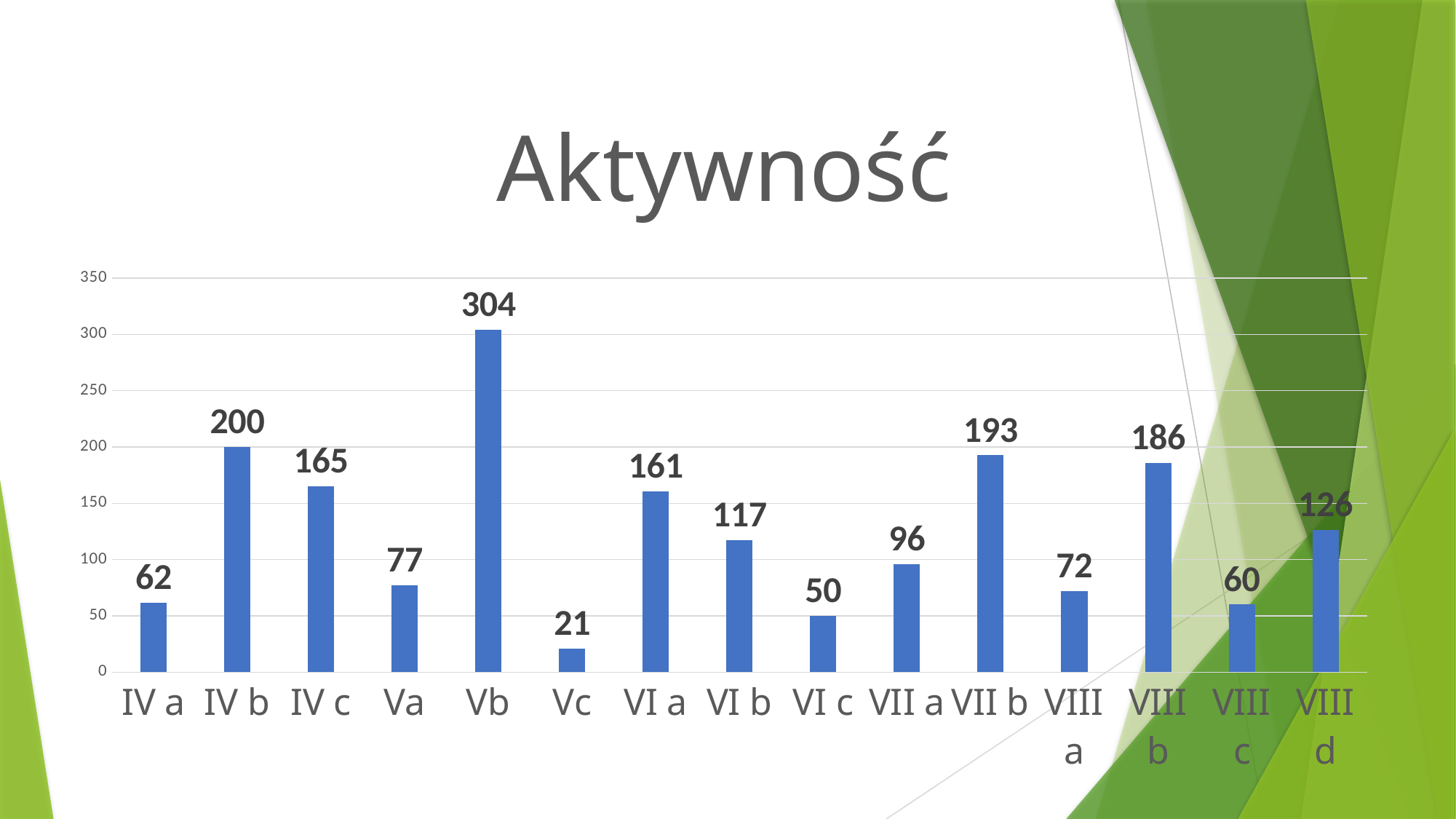
Is the value for VI a greater or less than 150? greater What kind of chart is shown on the slide? bar chart Which category has the highest value? Vb What is the title of the chart? Aktywność How many categories are shown on the x axis? 15 Which is larger, the value for VII b or the value for VIII b? VII b What is the value for VI c? 50 Which category has the lowest value? Vc What is the value for Vb? 304 What is the value for VIII b? 186 What is the difference between the values for IV b and IV a? 138 What is the difference between the values for VIII d and VIII c? 66